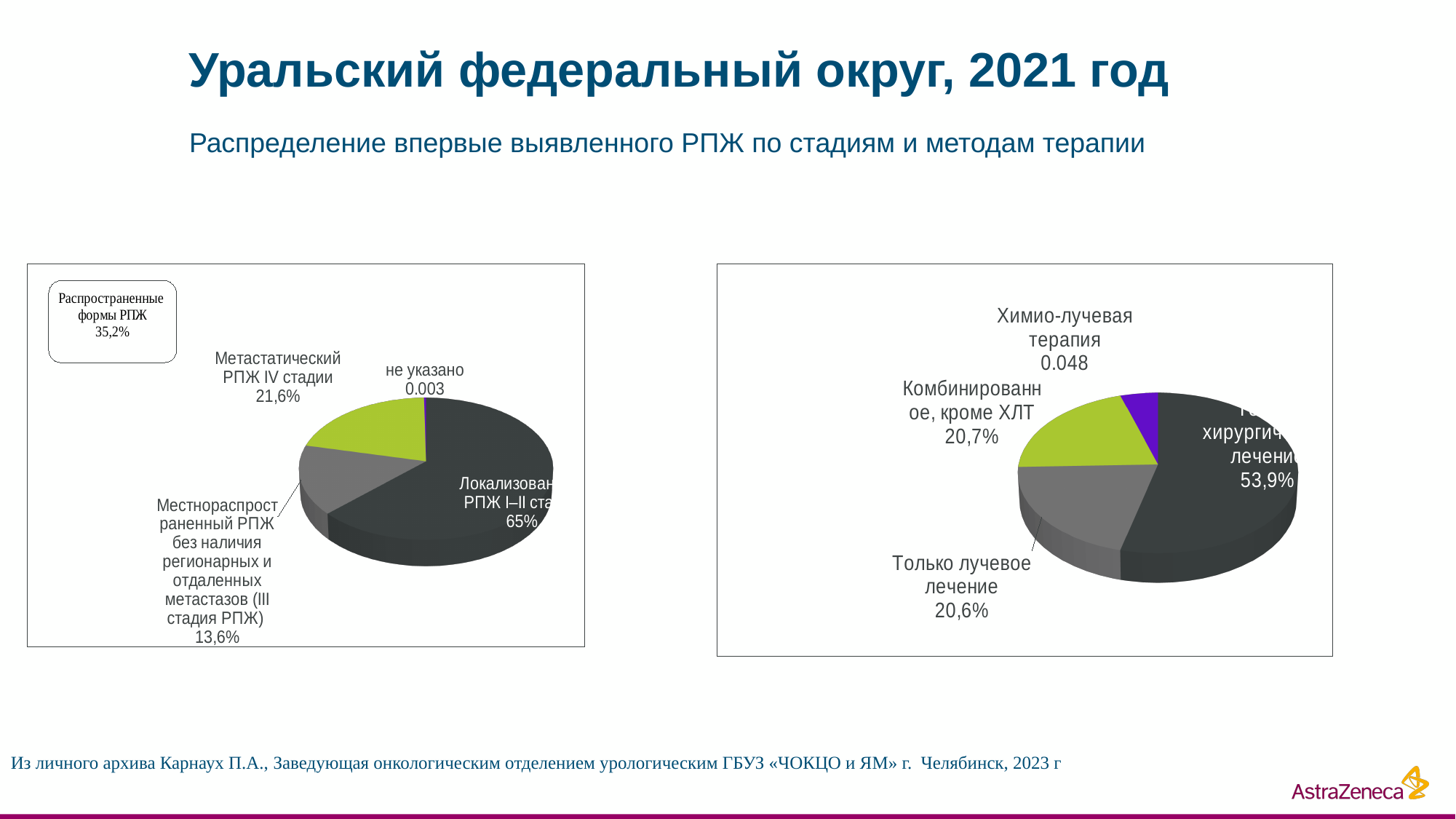
On the left pie chart, what is the difference between the shares for Метастатический РПЖ IV стадии and Местнораспространенный РПЖ (III стадия)? 8% On the right pie chart, what value is shown for Химио-лучевая терапия? 0.048 What type of chart is used on the right side of the slide? Pie chart On the left pie chart, what share is shown for Метастатический РПЖ IV стадии? 21,6% On the left pie chart, what percentage is given in the callout box for Распространенные формы РПЖ? 35,2% On the left pie chart, what value is shown for the slice labelled 'не указано'? 0.003 On the right pie chart, what share is shown for the largest slice (surgical treatment only)? 53,9% On the left pie chart, which category has the largest share? Локализованный РПЖ I–II стадии On the right pie chart, what share is shown for Только лучевое лечение? 20,6% On the right pie chart, what share is shown for Комбинированное, кроме ХЛТ? 20,7% On the left pie chart, what share is shown for Местнораспространенный РПЖ (III стадия РПЖ)? 13,6% On the left pie chart, what share is shown for Локализованный РПЖ I–II стадии? 65%